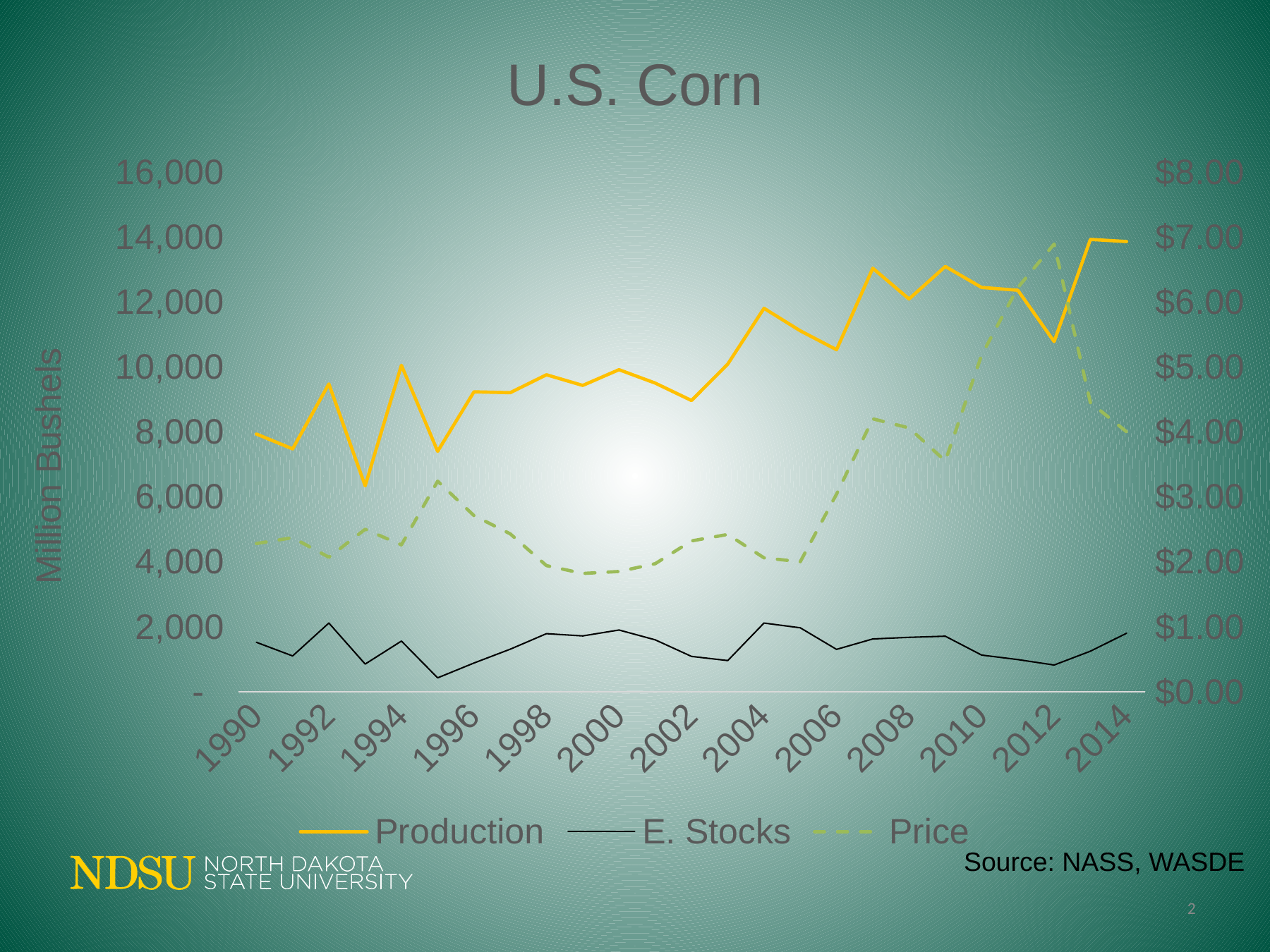
Is the Production value for 1993 greater or less than 8,000? less Is the Production value for 2014 greater or less than 12,000? greater Is the Price value for 2012 greater or less than $6.00? greater Which series is drawn with a dashed line? Price In which year is Production lowest? 1993 What is the title of the chart? U.S. Corn Does the Price rise or fall from 2012 to 2014? fall How many series does the legend list? 3 In which year is the Price highest? 2012 What kind of chart is shown on the slide? line chart